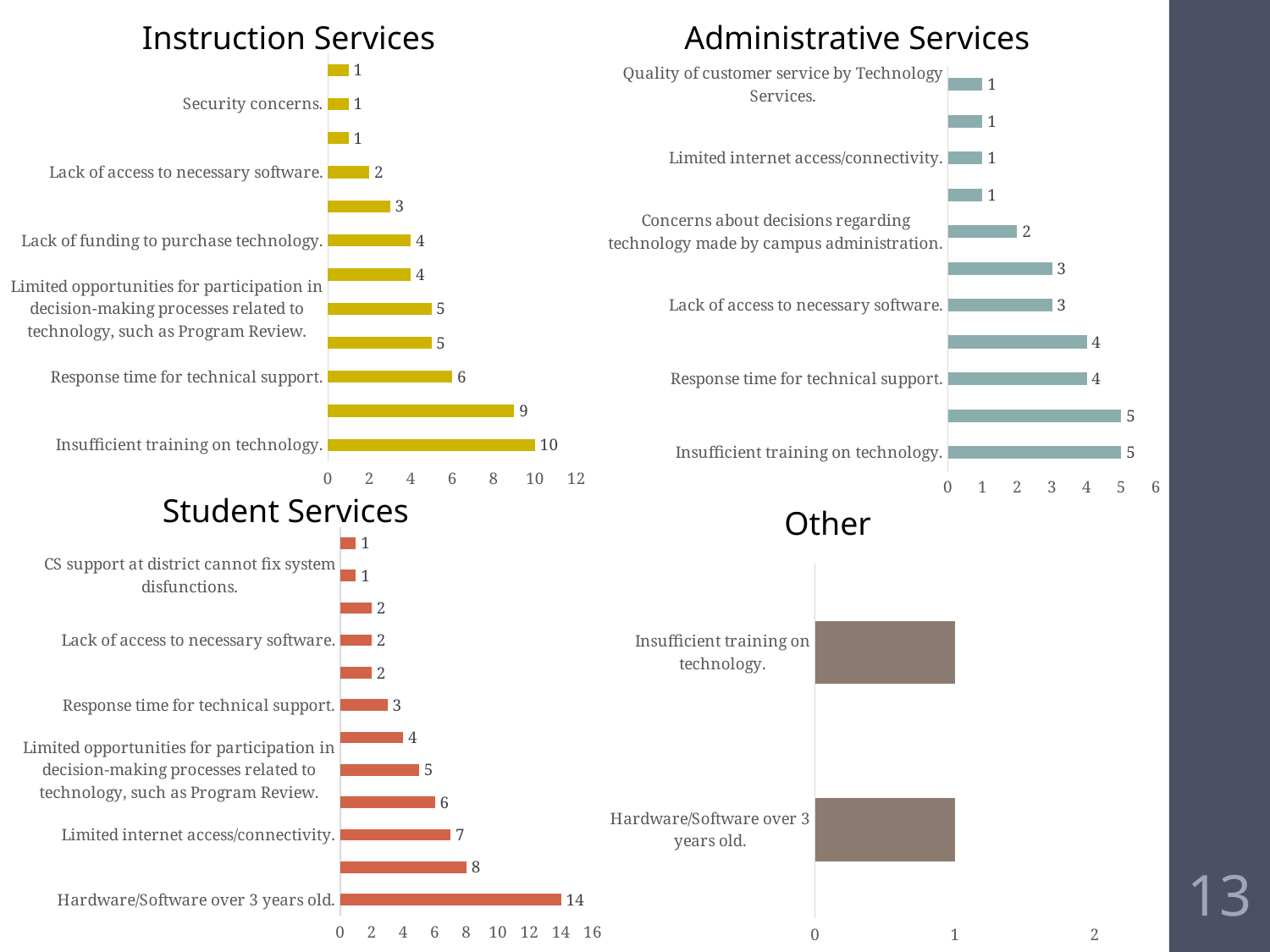
In the Student Services chart, which is larger: the value for "Response time for technical support." or the value for "Lack of access to necessary software."? Response time for technical support. In the Other chart, how many categories are plotted? 2 What kind of chart is the Other chart? Bar chart In the Instruction Services chart, what is the difference between the values for "Insufficient training on technology." and "Response time for technical support."? 4 In the Administrative Services chart, how many bars are plotted? 11 In the Instruction Services chart, what is the value for "Lack of funding to purchase technology."? 4 In the Administrative Services chart, what is the value for "Concerns about decisions regarding technology made by campus administration."? 2 In the Instruction Services chart, what is the value for "Insufficient training on technology."? 10 In the Student Services chart, what is the value for "Limited internet access/connectivity."? 7 In the Student Services chart, which category has the highest value? Hardware/Software over 3 years old. In the Instruction Services chart, which category has the highest value? Insufficient training on technology. In the Administrative Services chart, what is the value for "Lack of access to necessary software."? 3